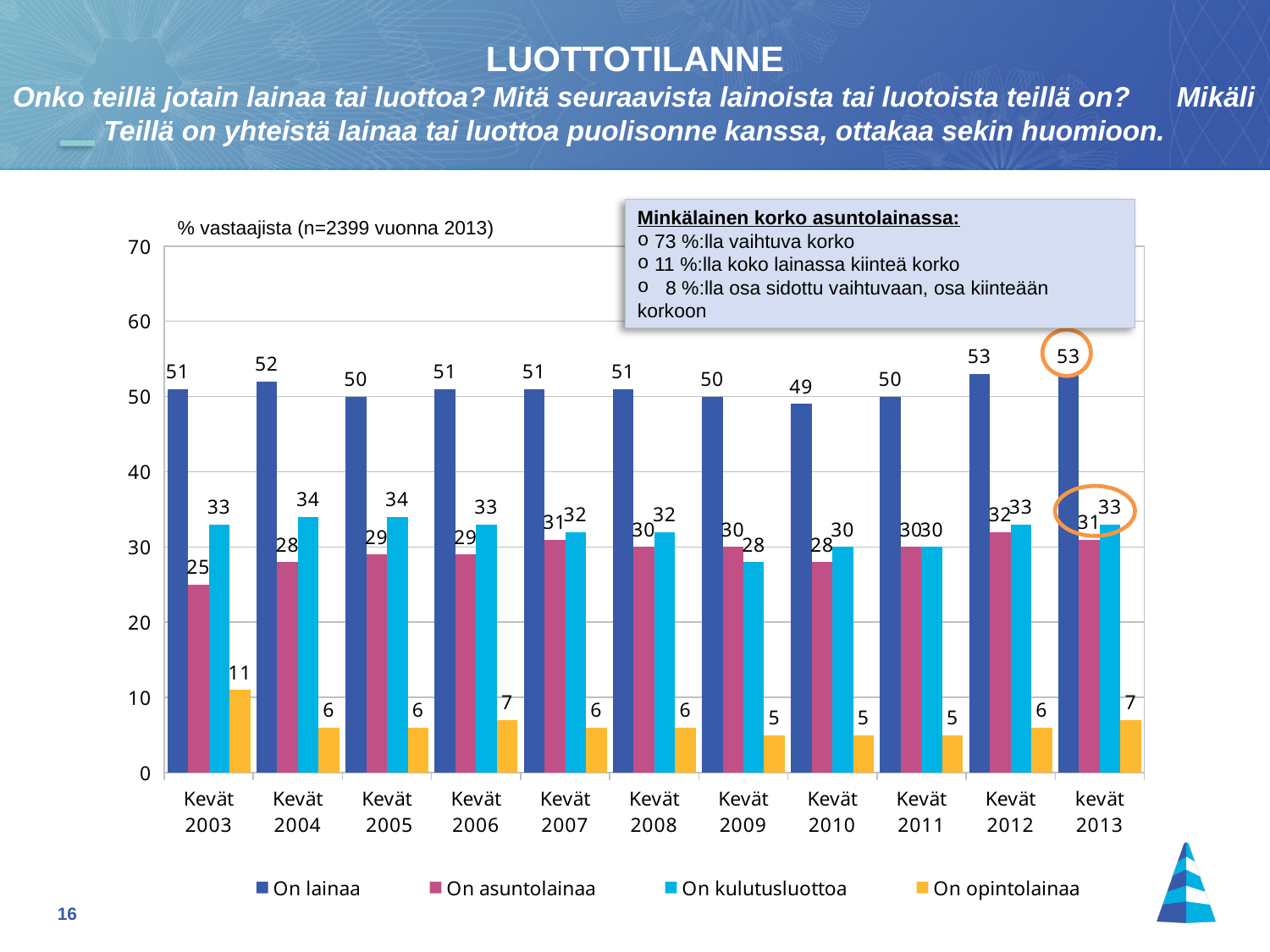
How many categories (years) are shown on the x axis? 11 What is the difference between On asuntolainaa in Kevät 2013 and Kevät 2003? 6 Which series is shown in yellow in the legend? On opintolainaa What is the value for On asuntolainaa in Kevät 2012? 32 What is the value for On kulutusluottoa in Kevät 2009? 28 What is the value for On lainaa in Kevät 2013? 53 Which is larger in Kevät 2010: On asuntolainaa or On kulutusluottoa? On kulutusluottoa In which year is the value for On opintolainaa highest? Kevät 2003 What kind of chart is shown on the slide? bar chart What is the value for On opintolainaa in Kevät 2003? 11 In which year is the value for On lainaa lowest? Kevät 2010 How many series does the legend list? 4